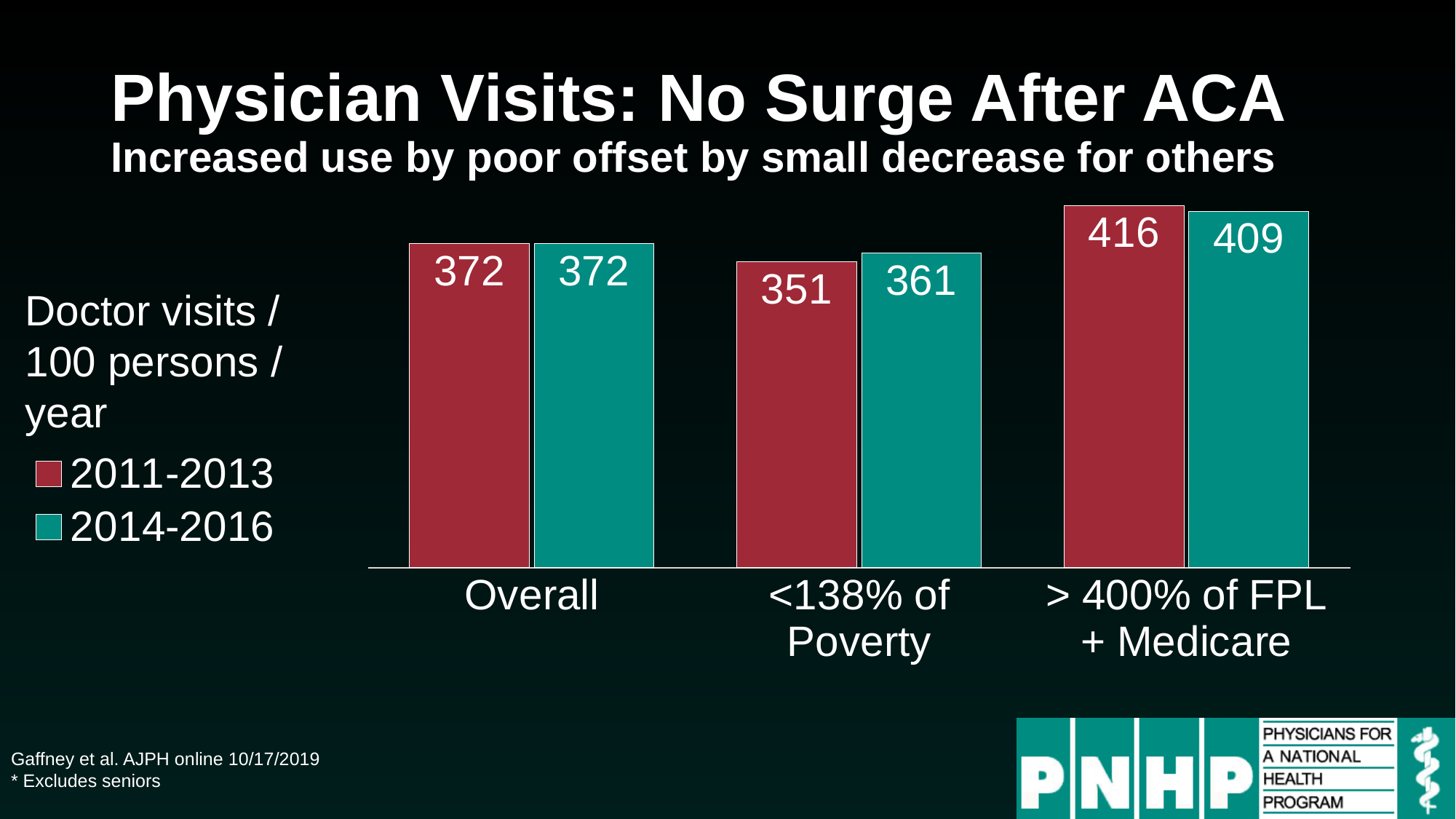
Which category has the highest value in the 2014-2016 series? > 400% of FPL + Medicare Which is larger for > 400% of FPL + Medicare: the 2011-2013 value or the 2014-2016 value? 2011-2013 What kind of chart is shown on the slide? Bar chart What is the difference between the 2011-2013 and 2014-2016 values for > 400% of FPL + Medicare? 7 What is the difference between the 2014-2016 and 2011-2013 values for <138% of Poverty? 10 What is the value for <138% of Poverty in the 2011-2013 series? 351 Which category has the lowest value in the 2011-2013 series? <138% of Poverty How many series does the legend list? 2 How many categories are shown on the x axis? 3 What is the value for Overall in the 2011-2013 series? 372 What is the value for > 400% of FPL + Medicare in the 2011-2013 series? 416 What is the value for <138% of Poverty in the 2014-2016 series? 361